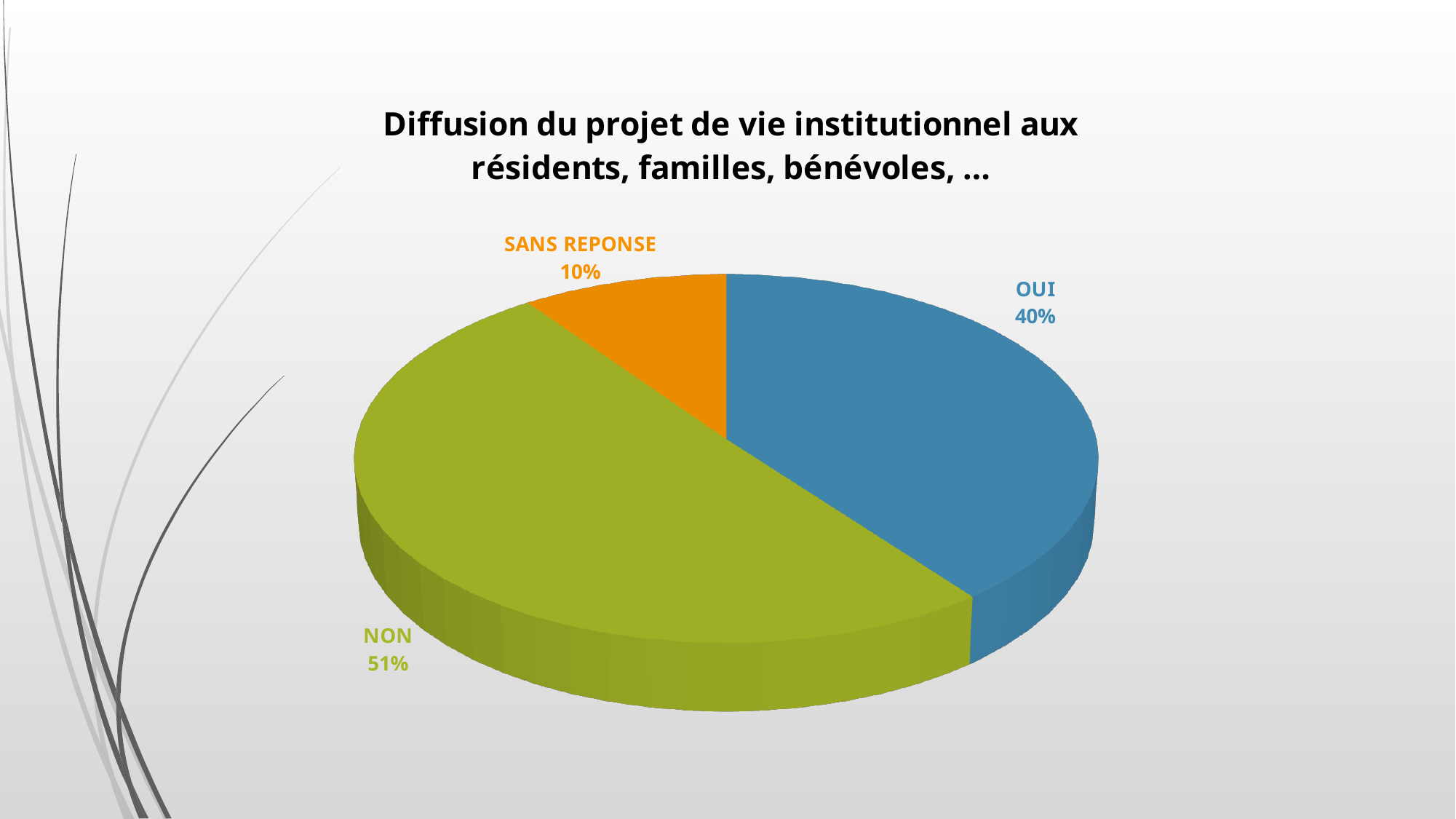
What is the difference in percentage points between OUI and SANS REPONSE? 30 What type of chart is shown on the slide? pie chart How many slices does the pie chart have? 3 Which is larger, the share for OUI or the share for SANS REPONSE? OUI Which category has the smallest share of the pie? SANS REPONSE What percentage is shown for SANS REPONSE? 10% What is the difference in percentage points between NON and OUI? 11 What colour is the NON slice? green What is the title of the chart? Diffusion du projet de vie institutionnel aux résidents, familles, bénévoles, … What percentage is shown for NON? 51% Which category has the largest share of the pie? NON What percentage is shown for OUI? 40%